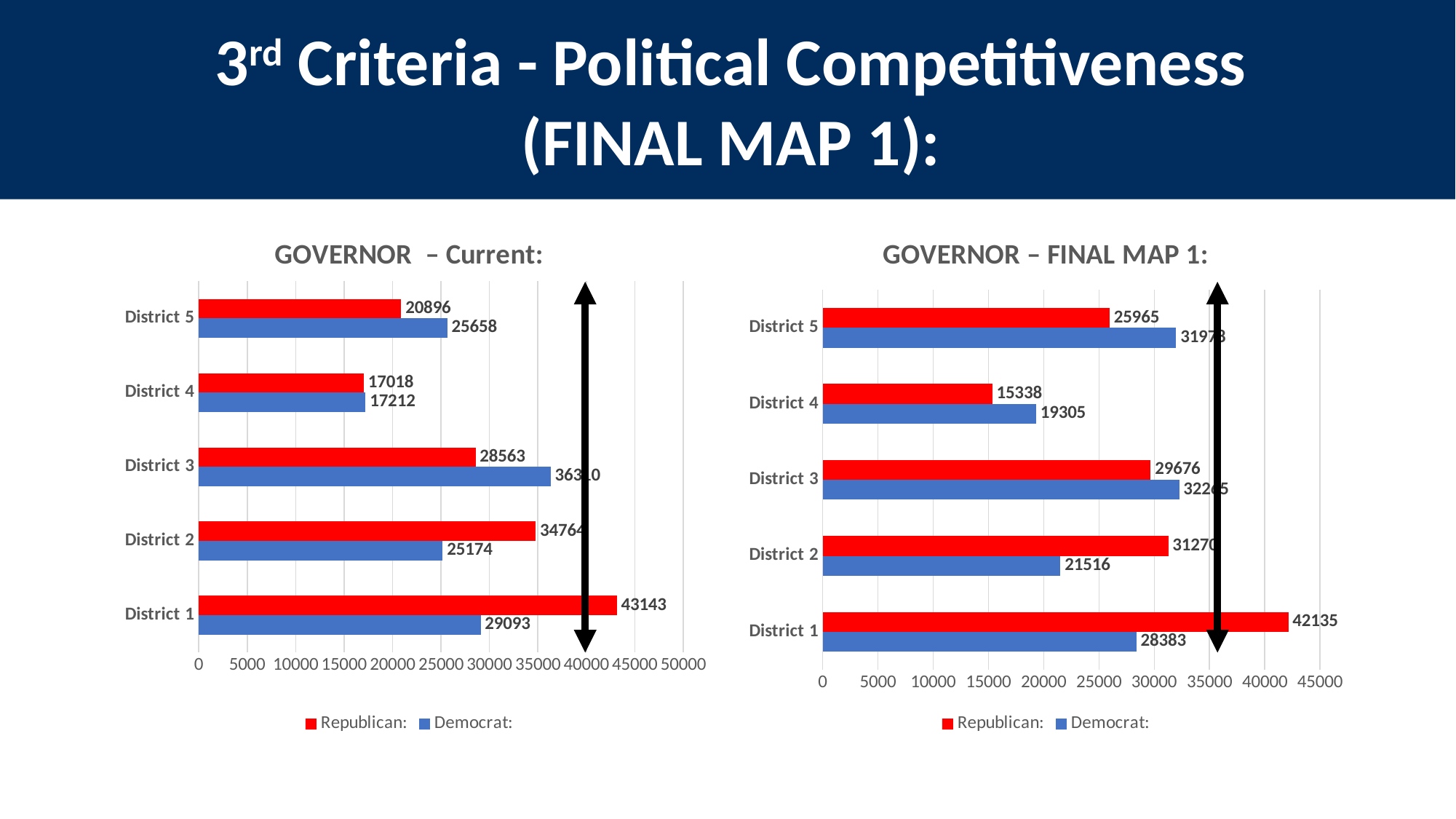
In the GOVERNOR – Current chart, which district has the highest Republican value? District 1 In the GOVERNOR – FINAL MAP 1 chart, what is the Democrat value for District 4? 19305 In the GOVERNOR – FINAL MAP 1 chart, what is the difference between the Republican and Democrat values for District 2? 9754 How many series does the legend of the GOVERNOR – FINAL MAP 1 chart list? 2 In the GOVERNOR – Current chart, what is the difference between the Republican and Democrat values for District 1? 14050 How many districts are shown in the GOVERNOR – Current chart? 5 In the GOVERNOR – Current chart, which is larger for District 5, the Republican value or the Democrat value? Democrat What kind of chart is the GOVERNOR – Current chart? bar chart In the GOVERNOR – FINAL MAP 1 chart, which district has the lowest Republican value? District 4 In the GOVERNOR – FINAL MAP 1 chart, what is the Republican value for District 2? 31270 In the GOVERNOR – FINAL MAP 1 chart, is the Democrat value for District 3 greater or less than 30000? greater In the GOVERNOR – Current chart, what is the Republican value for District 1? 43143